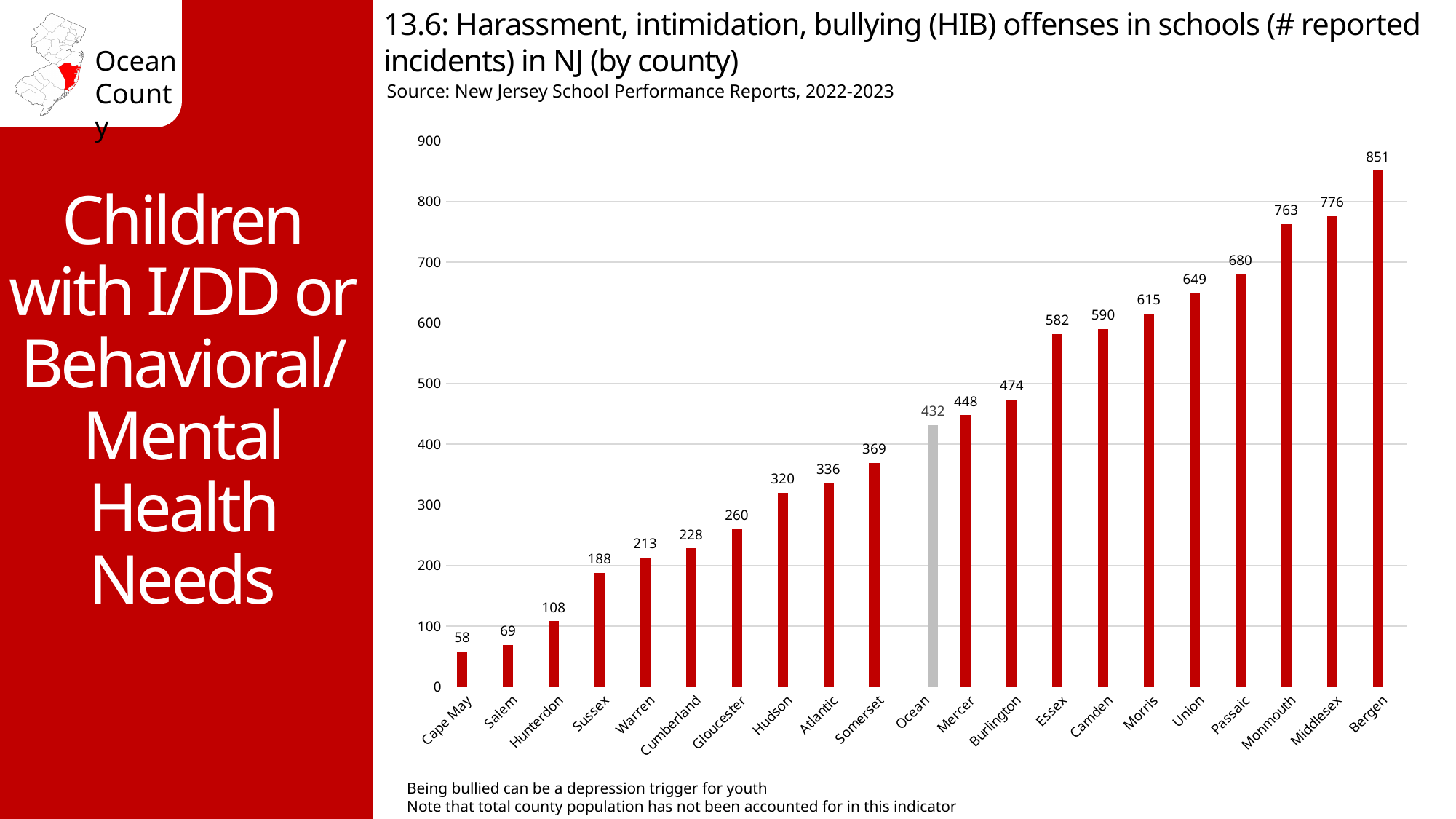
What is the difference between the values for Middlesex and Monmouth? 13 Is the value for Passaic greater or less than 700? less Do the values rise or fall moving from left to right along the x axis? rise How many counties are shown on the x axis? 21 Which county has the lowest number of reported HIB incidents? Cape May What is the value shown for Bergen County? 851 What is the difference between the values for Bergen and Ocean? 419 Which county has the highest number of reported HIB incidents? Bergen Which county's bar is coloured grey instead of red? Ocean Which county has more reported HIB incidents, Essex or Camden? Camden What type of chart is shown on the slide? bar chart How many reported HIB incidents does the chart show for Ocean County? 432